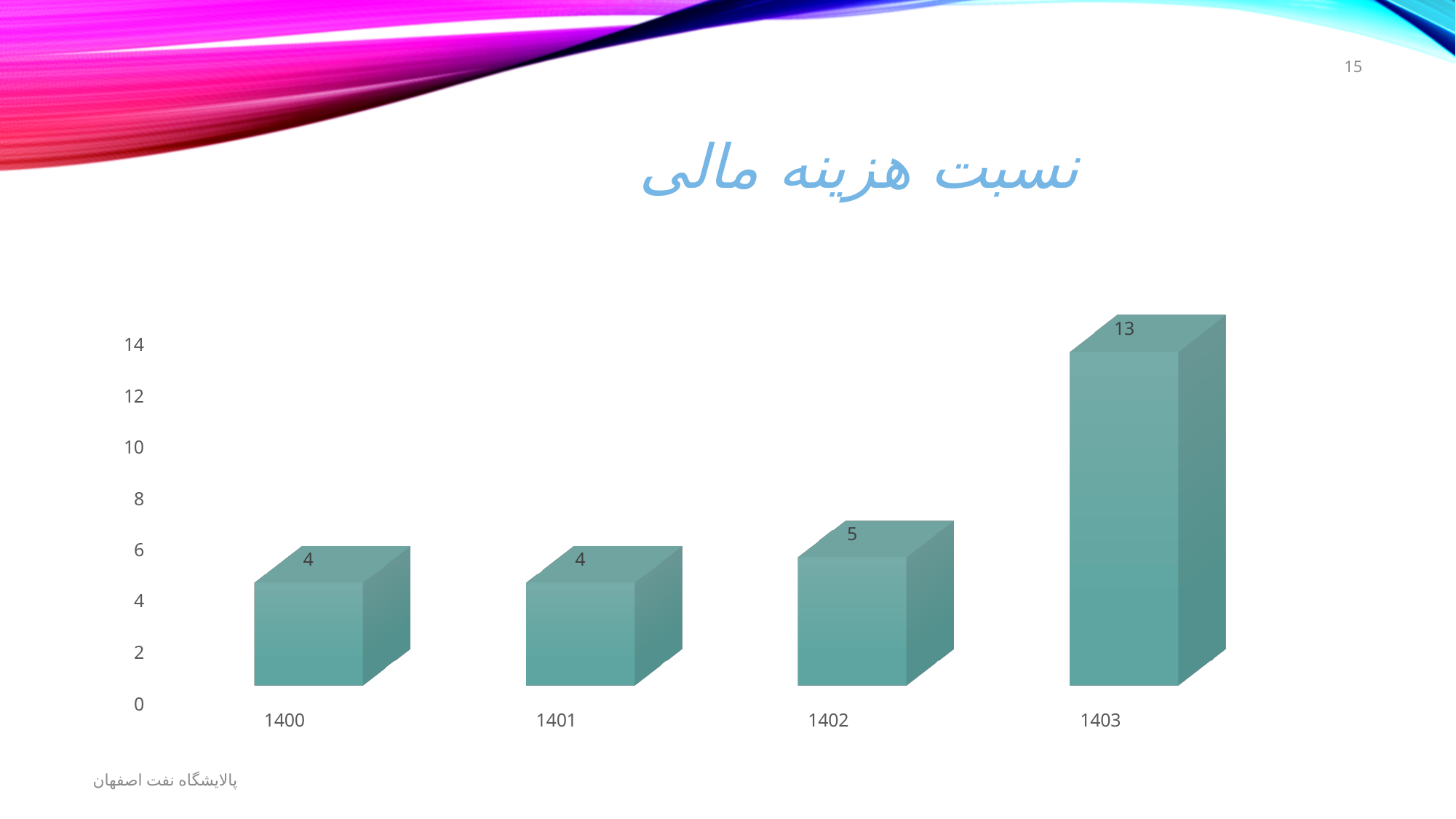
Is the value for 1403 greater or less than 10? greater What is the difference between the values for 1402 and 1401? 1 What is the value for 1402? 5 What is the value for 1403? 13 Do the values rise or fall from 1400 to 1403? rise Which is larger, the value for 1402 or the value for 1401? 1402 Which year has the highest value? 1403 What is the title of the chart on the slide? نسبت هزینه مالی What kind of chart is shown on the slide? bar chart How many years are shown on the x axis? 4 What is the difference between the values for 1403 and 1402? 8 What is the value for 1400? 4